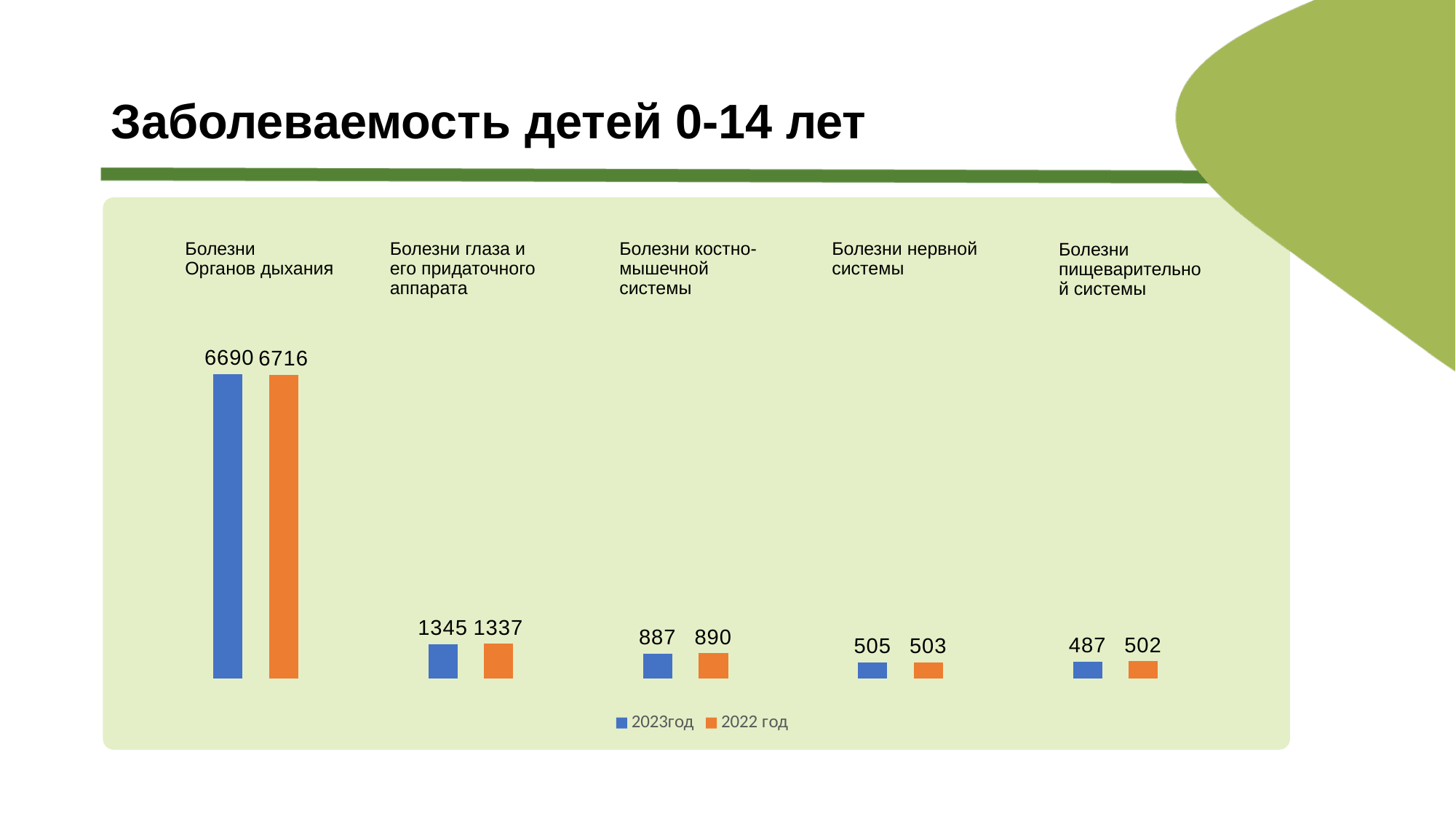
What is the value for Болезни нервной системы in 2022 год? 503 What is the value for Болезни органов дыхания in 2023год? 6690 How many disease categories are shown in the chart? 5 What is the difference between the 2022 год and 2023год values for Болезни органов дыхания? 26 What is the value for Болезни глаза и его придаточного аппарата in 2023год? 1345 Which category has the lowest value in 2023год? Болезни пищеварительной системы Which category has the highest value in 2023год? Болезни органов дыхания What kind of chart is shown on the slide? Bar chart What is the difference between the 2023год and 2022 год values for Болезни глаза и его придаточного аппарата? 8 Which colour represents 2022 год in the chart? Orange How many series does the legend list? 2 Which is larger for Болезни пищеварительной системы: the 2023год value or the 2022 год value? 2022 год